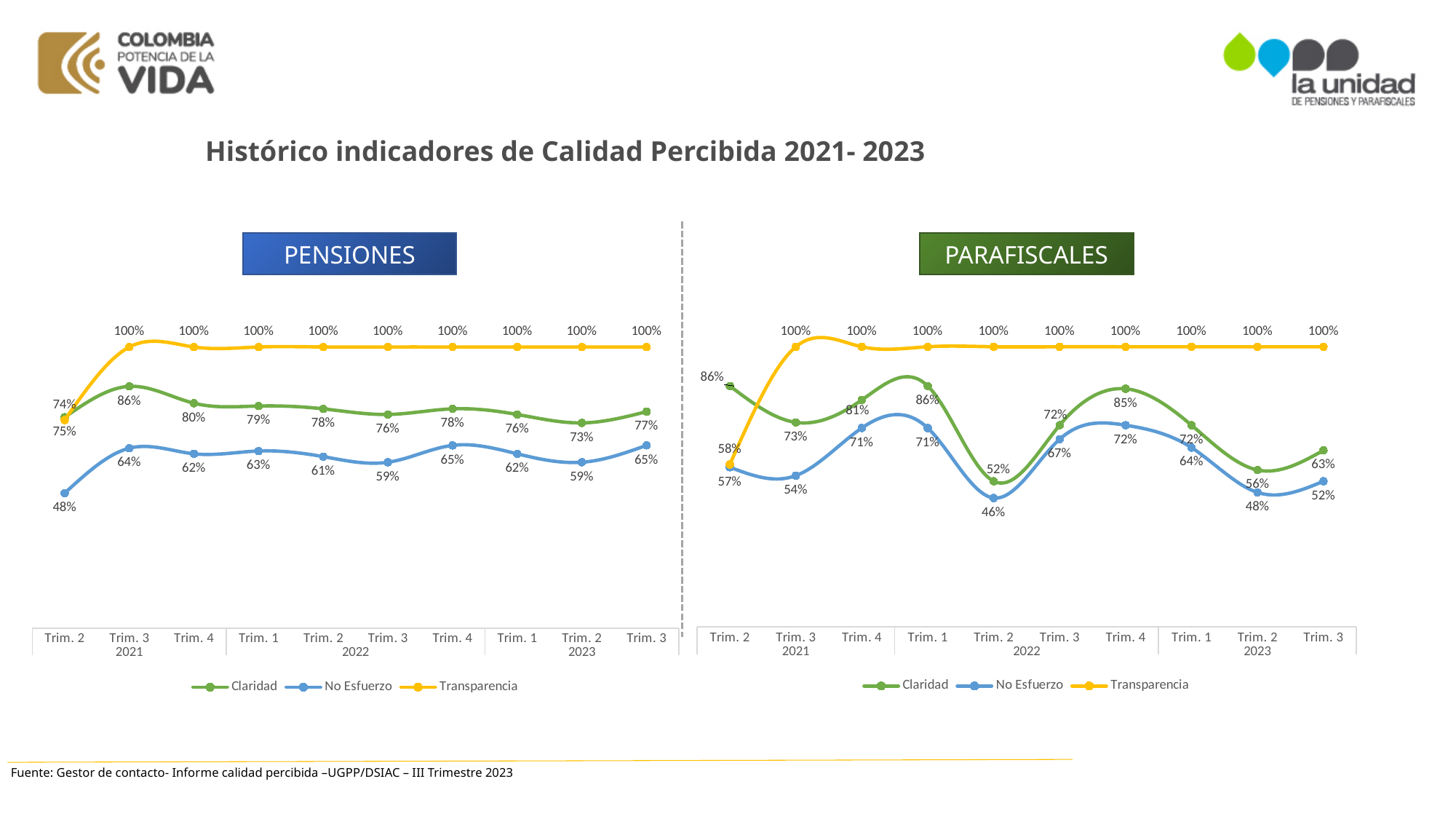
In the PENSIONES chart, what is the No Esfuerzo value for Trim. 2 2021? 48% In the PARAFISCALES chart, which quarter has the lowest Claridad value? Trim. 2 2022 In the PENSIONES chart, which quarter has the highest Claridad value? Trim. 3 2021 In the PARAFISCALES chart, what is the No Esfuerzo value for Trim. 2 2022? 46% What type of chart is the PARAFISCALES chart? Line chart In the PARAFISCALES chart, what is the Claridad value for Trim. 3 2023? 63% How many quarters are plotted on the x axis of the PENSIONES chart? 10 In the PARAFISCALES chart, what is the difference between the Claridad and No Esfuerzo values for Trim. 4 2022? 13% In the PENSIONES chart, what is the Claridad value for Trim. 3 2021? 86% How many series does the legend of the PARAFISCALES chart list? 3 In the PENSIONES chart, which is larger for Trim. 3 2023: Claridad or No Esfuerzo? Claridad In the PENSIONES chart, what is the Transparencia value for Trim. 2 2021? 74%